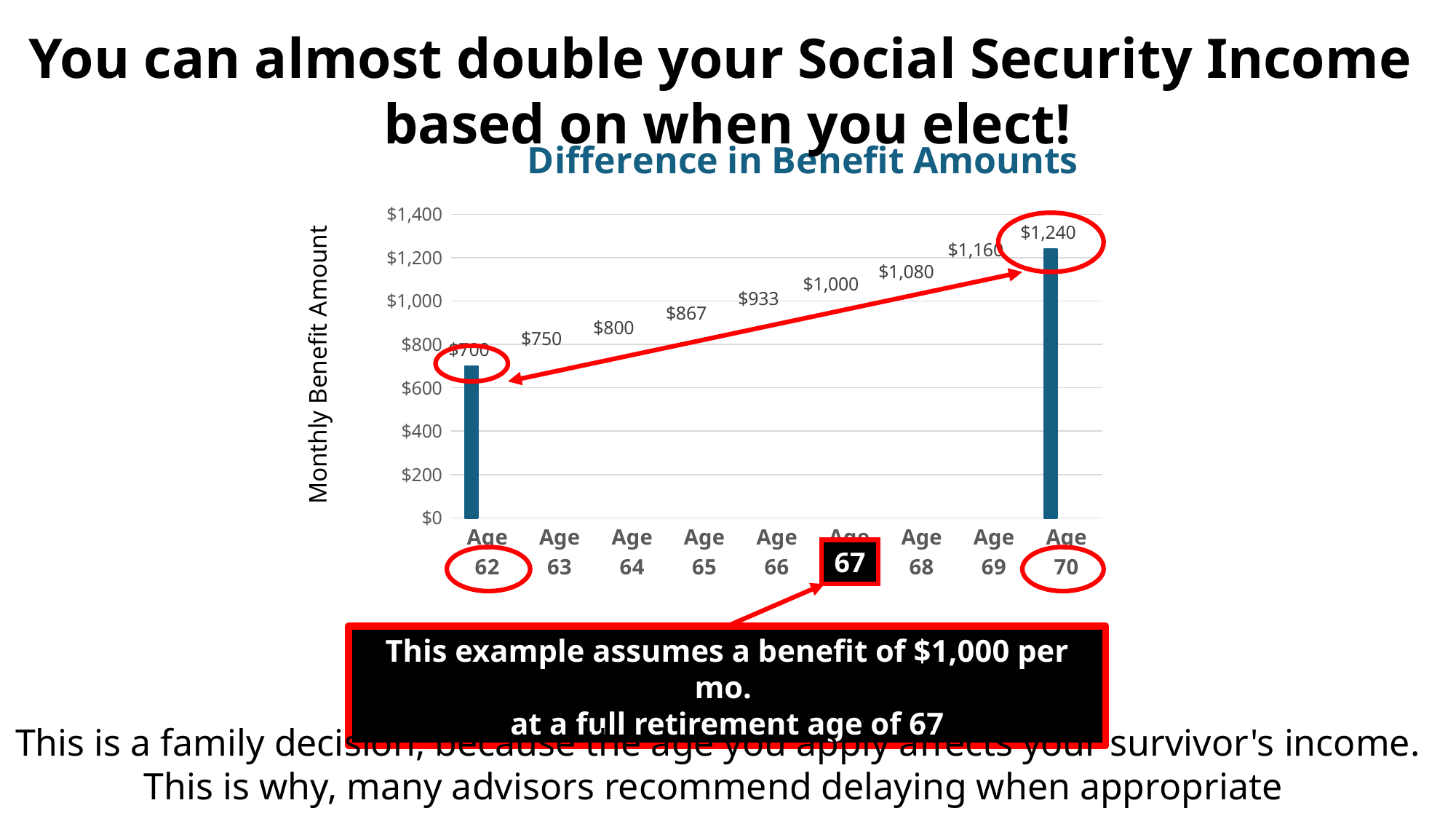
What is the monthly benefit amount shown for Age 67? $1,000 Do the benefit amounts rise or fall as age increases along the x axis? rise Which age has the highest monthly benefit amount? Age 70 What is the difference between the benefit amounts for Age 70 and Age 67? $240 How many age categories are shown on the x axis? 9 What is the monthly benefit amount shown for Age 65? $867 What is the monthly benefit amount shown for Age 70? $1,240 Which has a larger benefit amount, Age 64 or Age 66? Age 66 What is the monthly benefit amount shown for Age 63? $750 What is the difference between the benefit amounts for Age 68 and Age 66? $147 Which age has the lowest monthly benefit amount? Age 62 Is the value for Age 62 greater or less than $800? less